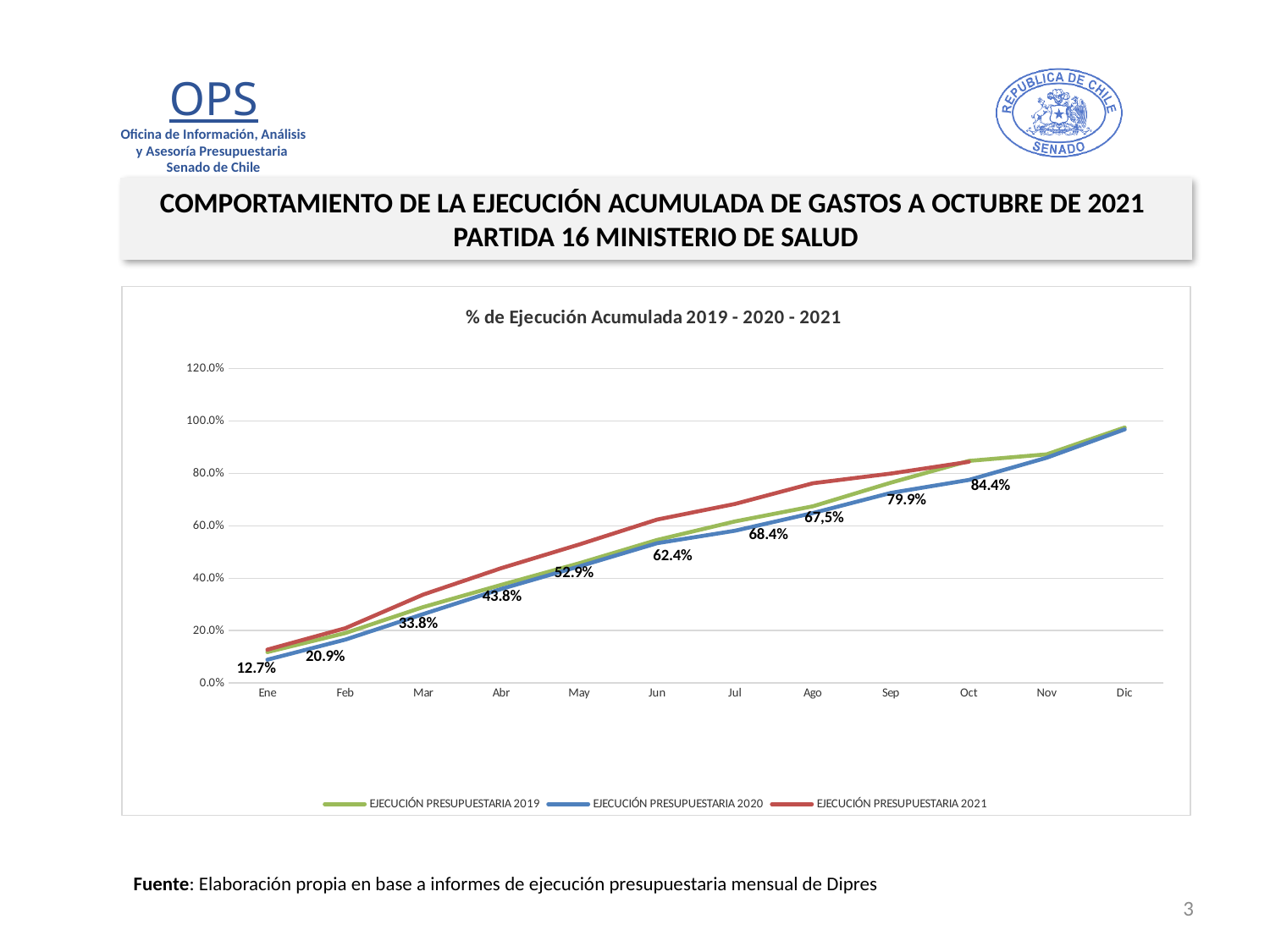
What is the title of the chart? % de Ejecución Acumulada 2019 - 2020 - 2021 What is the labelled value for EJECUCIÓN PRESUPUESTARIA 2021 in Ene? 12.7% How many series does the legend list? 3 Is the value for EJECUCIÓN PRESUPUESTARIA 2020 in Mar greater or less than 40%? less How many months are shown along the x axis? 12 By how many percentage points did EJECUCIÓN PRESUPUESTARIA 2021 increase from Ene to Feb? 8.2% What is the labelled value for EJECUCIÓN PRESUPUESTARIA 2021 in Jul? 68.4% By how many percentage points did EJECUCIÓN PRESUPUESTARIA 2021 increase from Sep to Oct? 4.5% What is the labelled value for EJECUCIÓN PRESUPUESTARIA 2021 in Oct? 84.4% What kind of chart is shown on the slide? line chart What is the labelled value for EJECUCIÓN PRESUPUESTARIA 2021 in May? 52.9% Do the values of the series rise or fall from Ene to Dic? rise